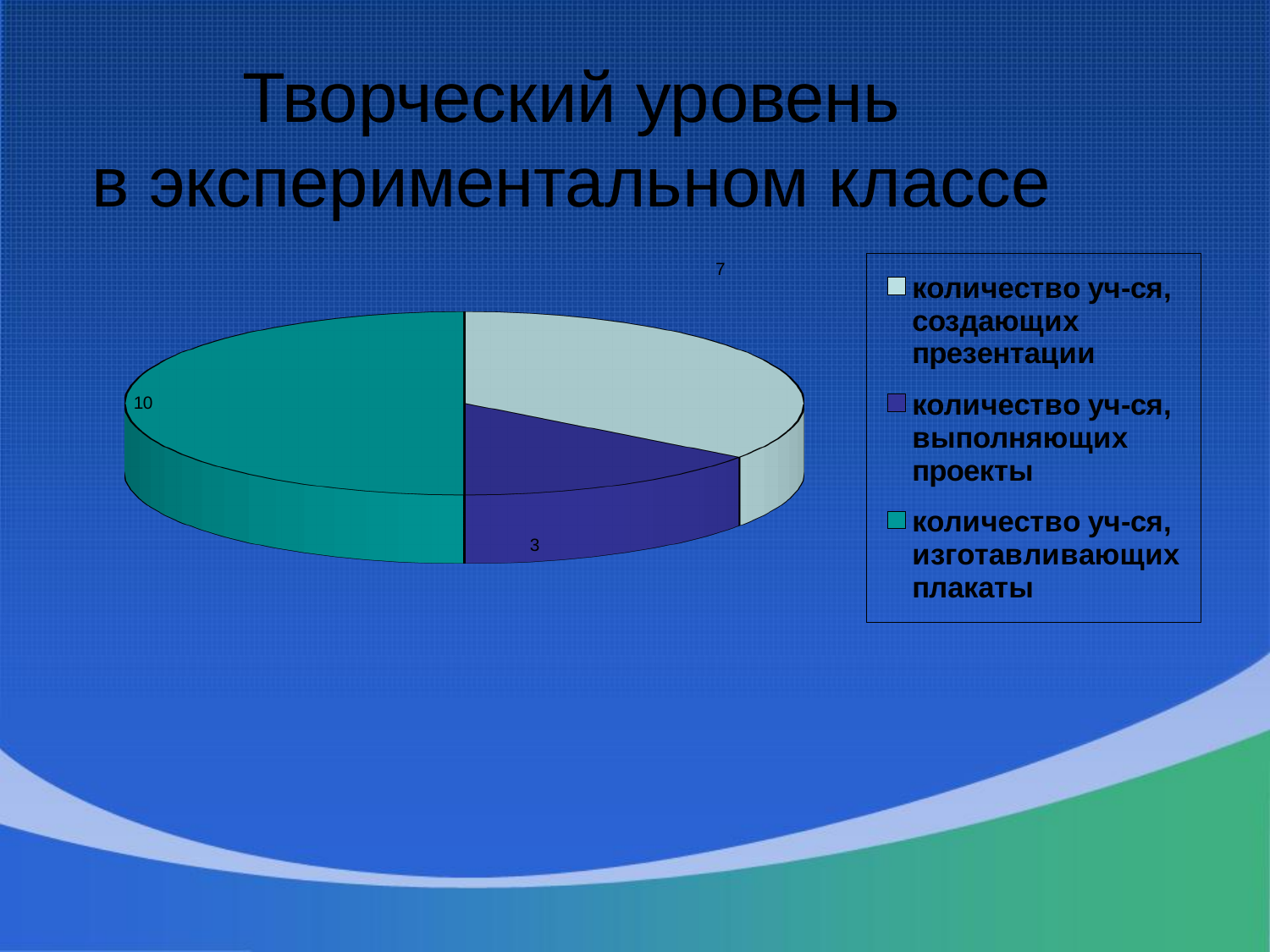
Which category has the smallest slice of the pie? количество уч-ся, выполняющих проекты What is the value for "количество уч-ся, изготавливающих плакаты"? 10 Which is larger: the value for students creating presentations or the value for students doing projects? количество уч-ся, создающих презентации What type of chart is shown on the slide? pie chart What is the value for "количество уч-ся, создающих презентации"? 7 What is the title of the slide containing the chart? Творческий уровень в экспериментальном классе What is the difference between the value for students making posters and the value for students doing projects? 7 What share of the pie does the slice for students making posters represent? 50% Which category has the largest slice of the pie? количество уч-ся, изготавливающих плакаты How many slices does the pie chart have? 3 How many entries does the legend list? 3 What is the value for "количество уч-ся, выполняющих проекты"? 3